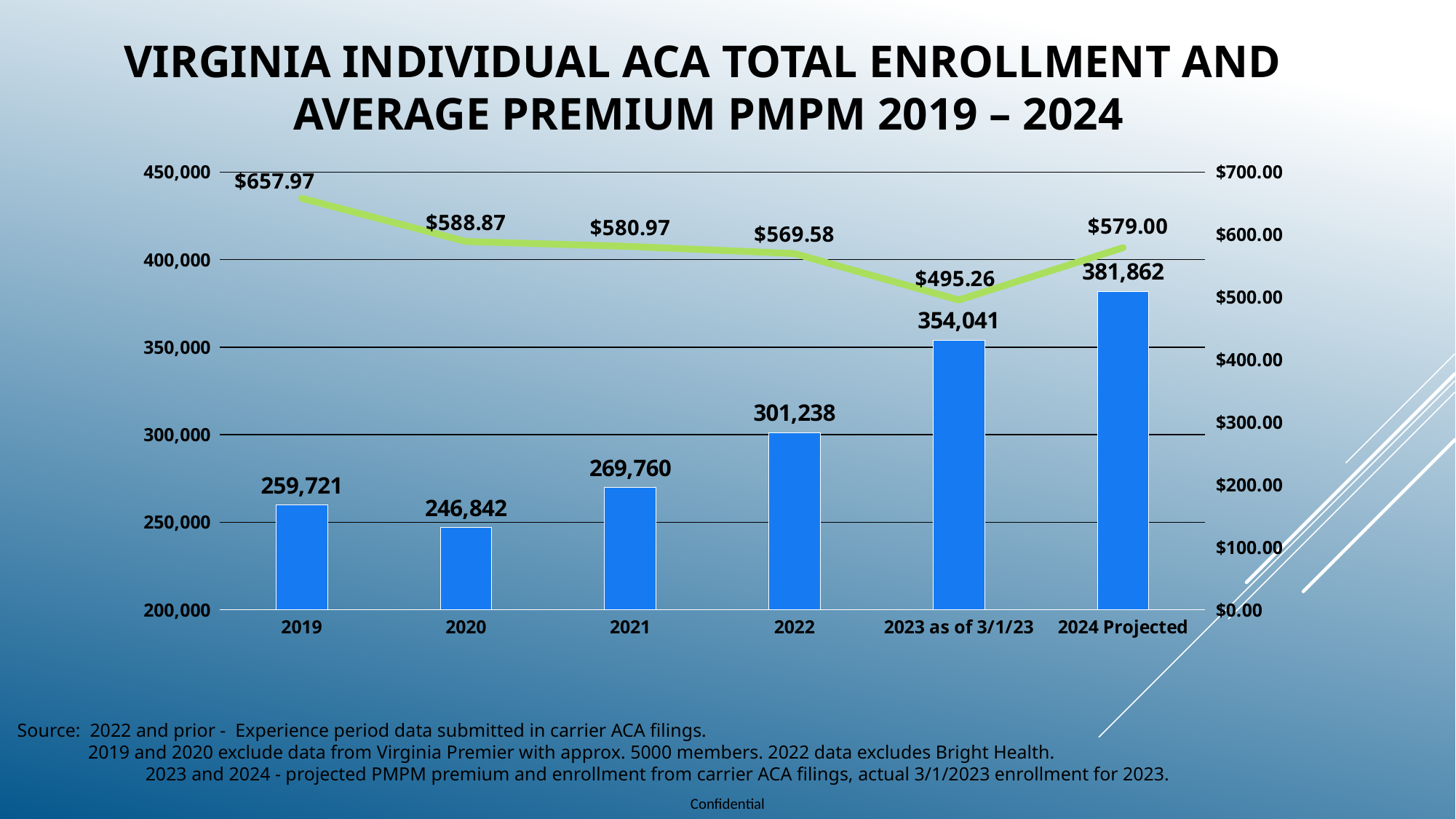
What is the difference in enrollment between 2024 Projected and 2023 as of 3/1/23? 27,821 Do the enrollment bars rise or fall from 2020 through 2024 Projected? Rise What is the enrollment value shown for 2024 Projected? 381,862 What is the average premium PMPM shown for 2023 as of 3/1/23? $495.26 Which year has the lowest enrollment bar? 2020 Which year has the lowest average premium PMPM on the line? 2023 as of 3/1/23 Which year has the highest average premium PMPM on the line? 2019 Which has the higher enrollment, 2019 or 2021? 2021 What is the difference in average premium PMPM between 2019 and 2023 as of 3/1/23? $162.71 How many years (categories) are shown on the x axis? 6 What is the enrollment value shown for 2022? 301,238 What is the average premium PMPM shown for 2019? $657.97